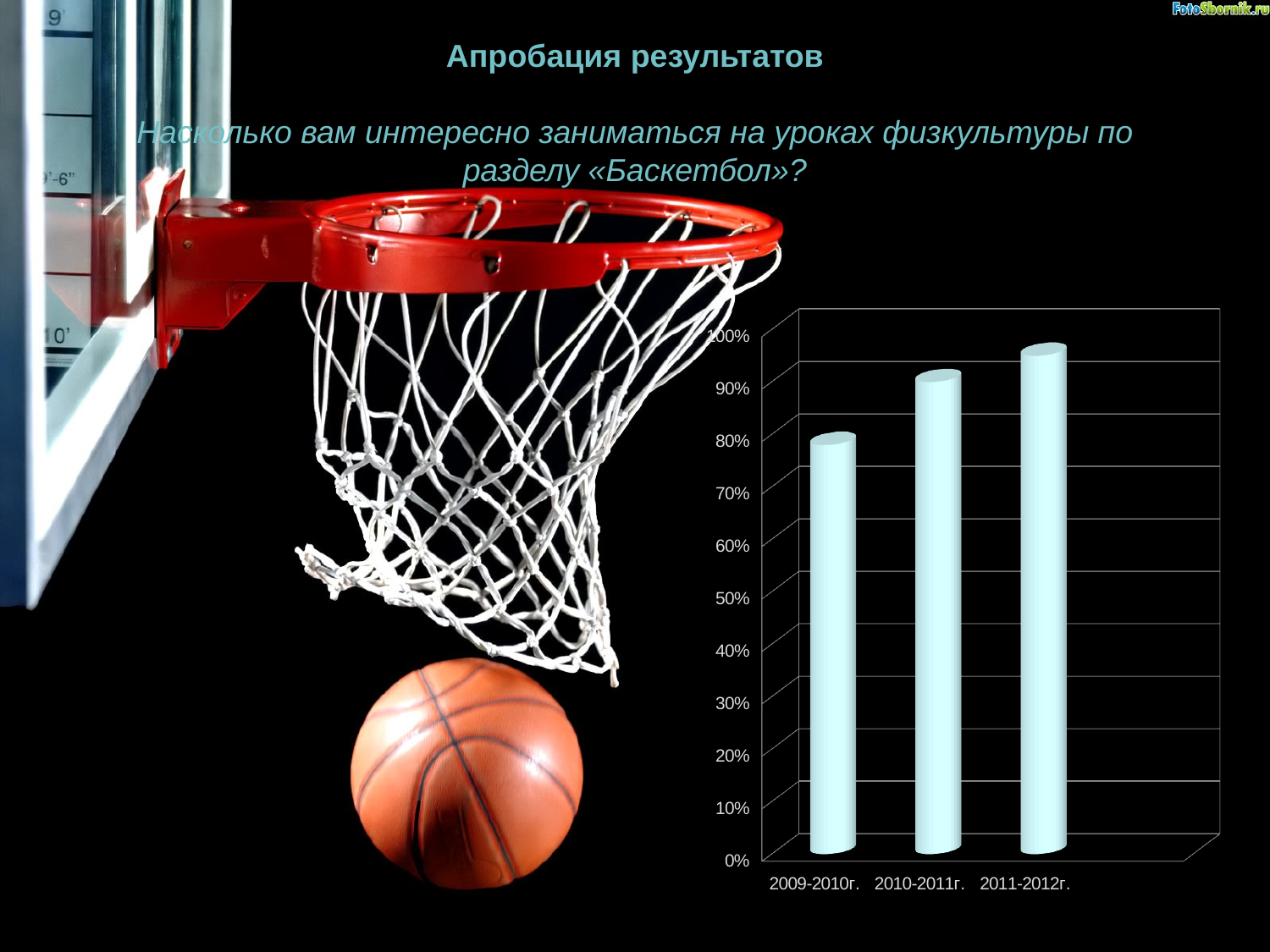
How many categories (school years) are plotted on the chart? 3 What is the highest percentage tick shown on the vertical axis of the chart? 100% Which is larger, the value for 2010-2011г. or the value for 2009-2010г.? 2010-2011г. Is the value for 2010-2011г. greater or less than 80%? greater Which school year has the lowest bar on the chart? 2009-2010г. Which is larger, the value for 2009-2010г. or the value for 2011-2012г.? 2011-2012г. Do the values rise or fall from 2009-2010г. to 2011-2012г.? rise What kind of chart is shown on the slide? bar chart Is the value for 2009-2010г. greater or less than 70%? greater Is the value for 2011-2012г. greater or less than 90%? greater Which school year has the highest bar on the chart? 2011-2012г.